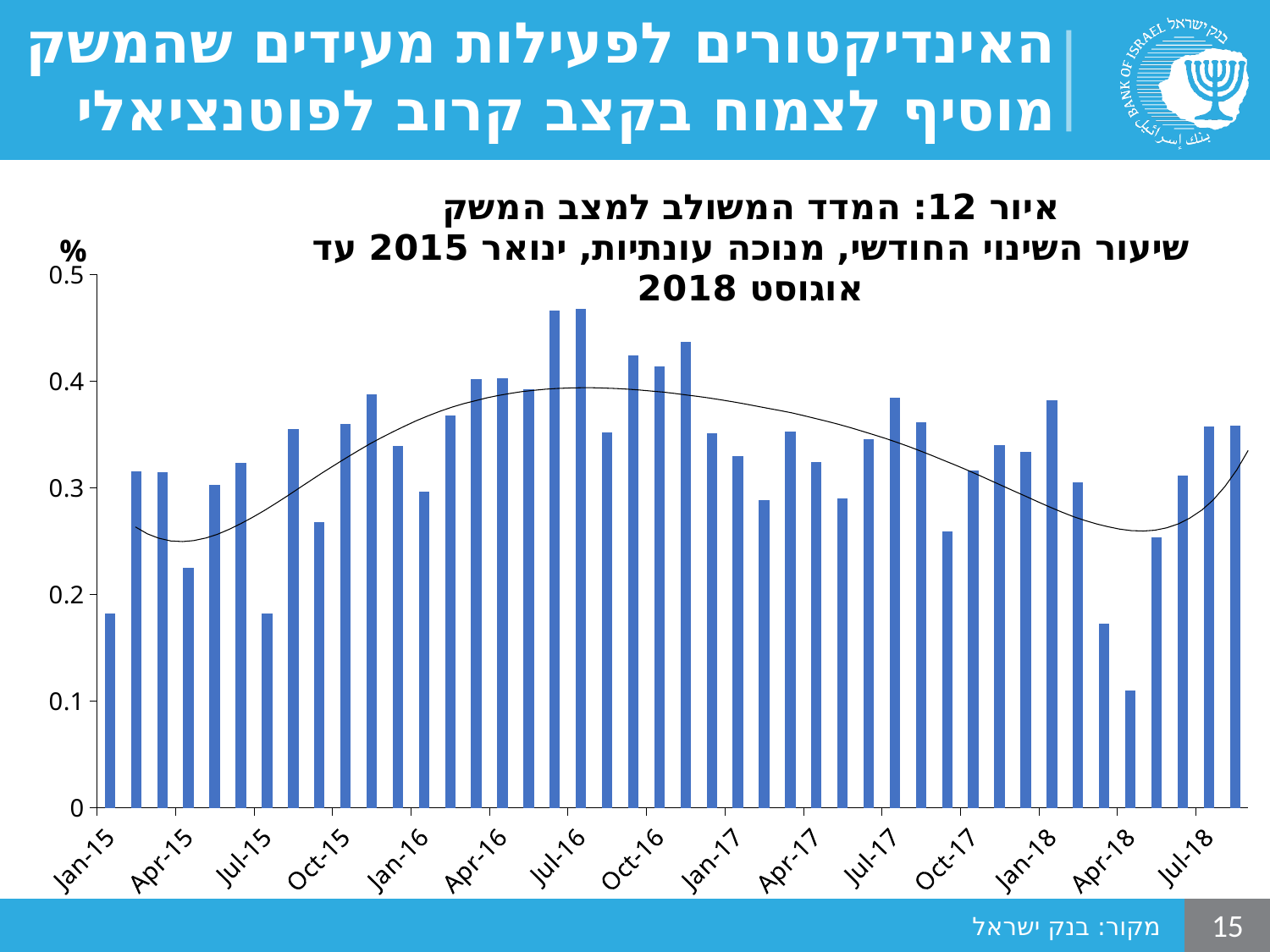
Which is larger, the value for Jan-18 or the value for Apr-18? Jan-18 What unit is shown at the top of the vertical axis? % Is the value for Apr-18 greater or less than 0.2? less What kind of chart is shown on the slide? bar chart What is the highest value shown on the vertical axis? 0.5 Is the value for Jan-15 greater or less than 0.2? less Which month has the lowest bar in the chart? Apr-18 Which is larger, the value for Jul-16 or the value for Apr-18? Jul-16 Is the value for Jul-15 greater or less than 0.2? less Do the bars rise or fall from Jan-18 to Apr-18? fall